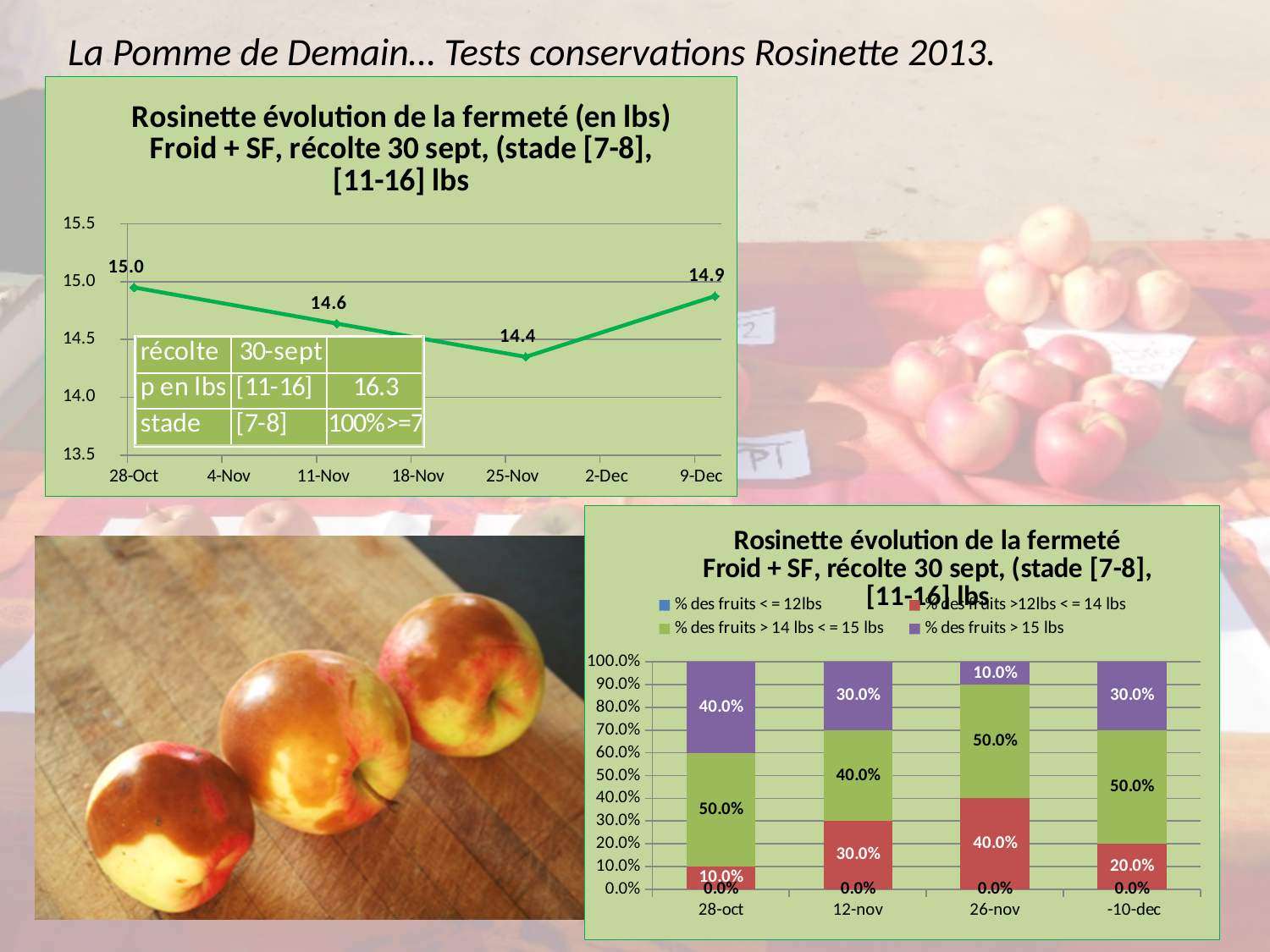
What kind of chart is the top-left chart? line chart In the top-left line chart, what is the firmness value at 25-Nov? 14.4 In the bottom-right stacked bar chart, is the '% des fruits > 14 lbs < = 15 lbs' value for 12-nov larger or smaller than the value for 26-nov? smaller In the top-left line chart, is the value at 9-Dec greater or less than 14.5? greater In the bottom-right stacked bar chart, which date has the highest value for '% des fruits > 15 lbs'? 28-oct In the top-left line chart, how many data points are plotted? 4 In the top-left line chart, what is the difference between the value at 28-Oct and the value at 11-Nov? 0.4 In the top-left line chart, which date has the lowest firmness value? 25-Nov In the bottom-right stacked bar chart, what is the value of '% des fruits >12lbs < = 14 lbs' for 26-nov? 40.0% In the top-left line chart, what is the firmness value at 28-Oct? 15.0 In the bottom-right stacked bar chart, how many series does the legend list? 4 In the bottom-right stacked bar chart, what is the value of '% des fruits > 15 lbs' for 28-oct? 40.0%